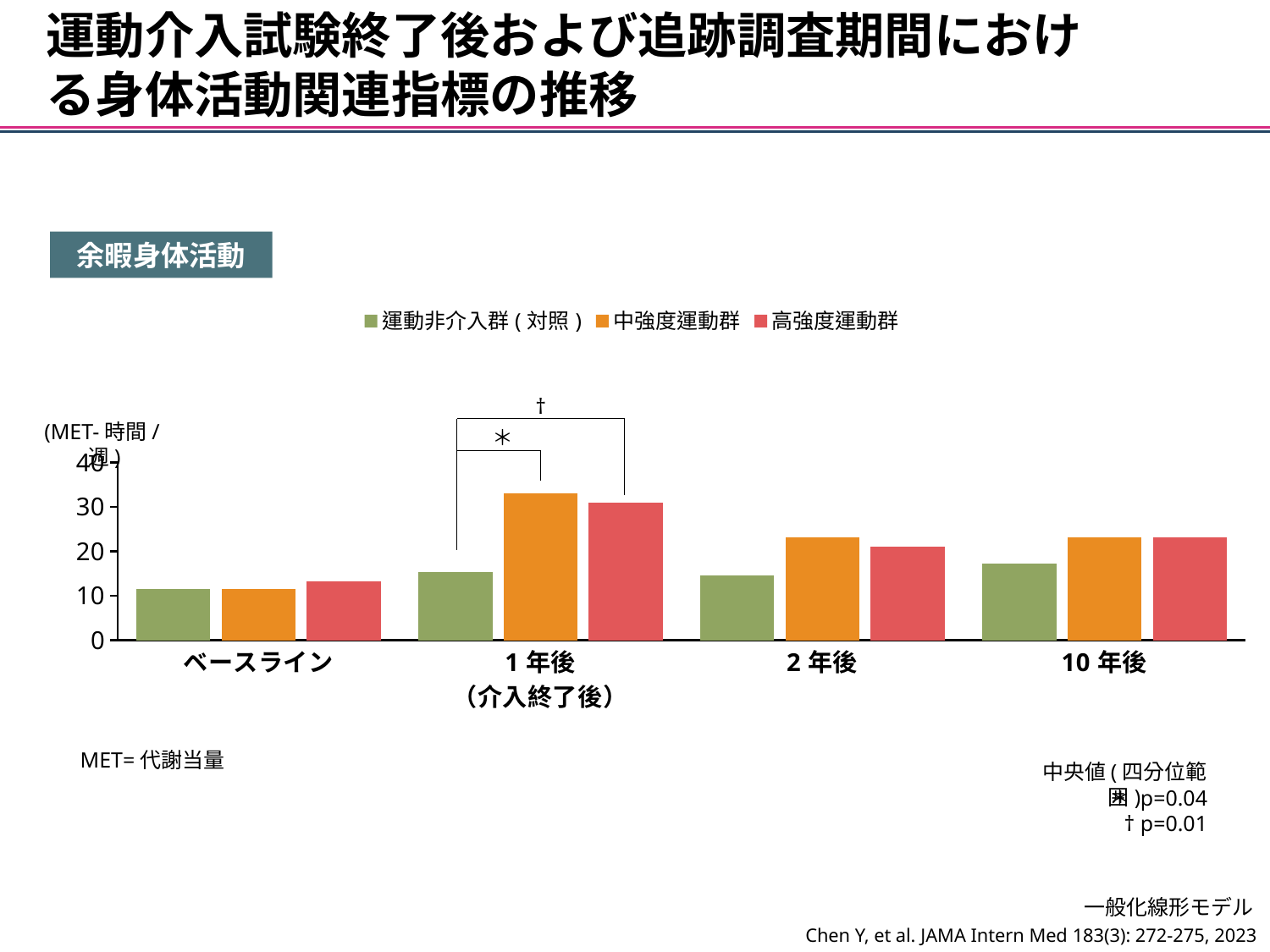
Is the value for 高強度運動群 at 10年後 greater or less than 20? greater Is the value for 運動非介入群(対照) at 2年後 greater or less than 20? less What kind of chart is shown on the slide? bar chart Does the value for 中強度運動群 rise or fall from ベースライン to 1年後（介入終了後）? rise How many series does the legend list? 3 Is the value for 中強度運動群 at 1年後（介入終了後） greater or less than 30? greater At 1年後（介入終了後）, which is larger: 中強度運動群 or 運動非介入群(対照)? 中強度運動群 At which time point is the 運動非介入群(対照) bar lowest? ベースライン At which time point is the 中強度運動群 bar highest? 1年後（介入終了後） Which colour represents 高強度運動群 in the legend? red How many time-point categories are shown on the x axis? 4